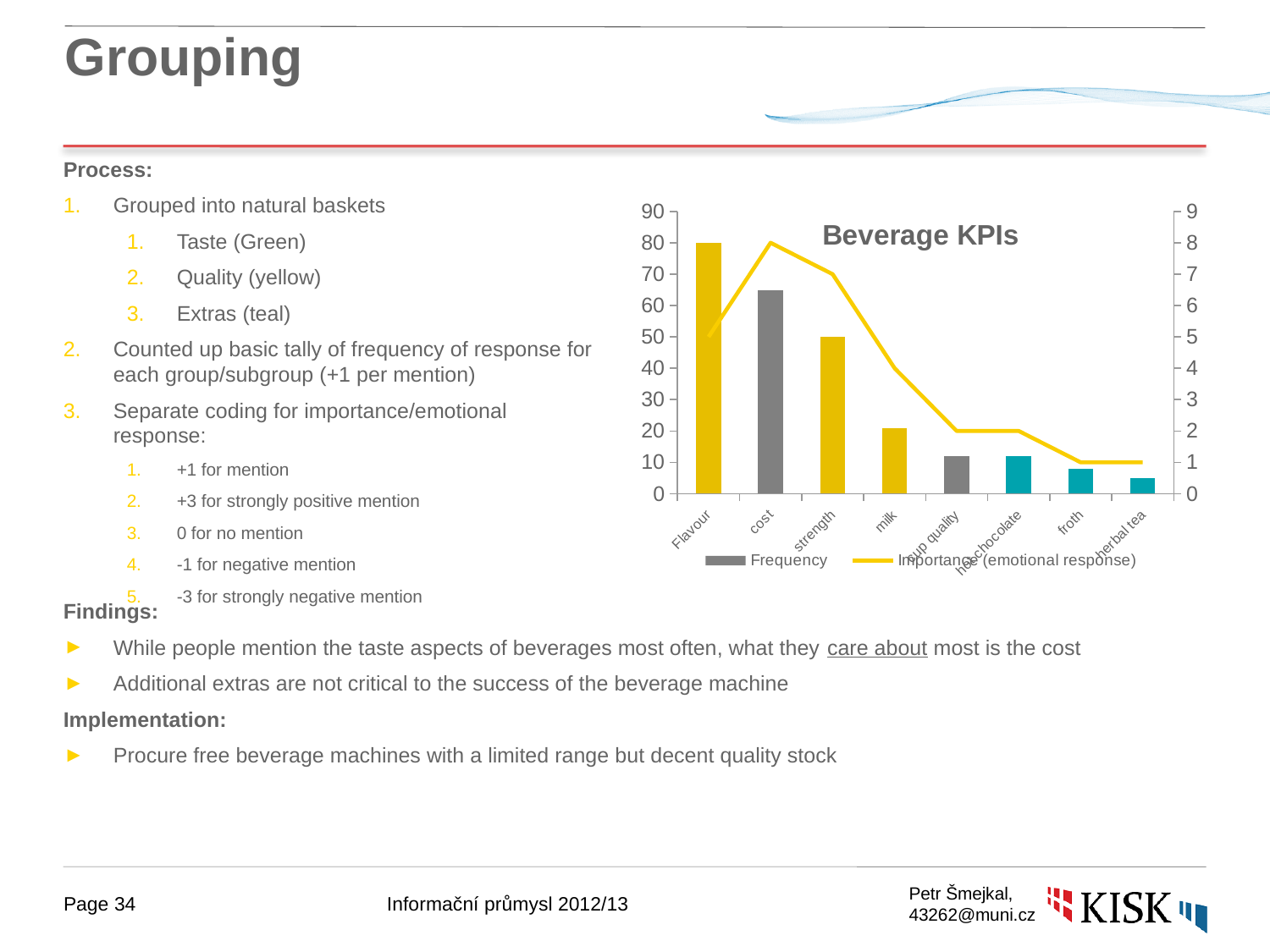
Which category has the lowest Frequency bar in the Beverage KPIs chart? herbal tea What is the title of the chart on the slide? Beverage KPIs How many categories are shown on the x axis of the Beverage KPIs chart? 8 Does the Importance (emotional response) line rise or fall from strength to herbal tea? fall Is the Frequency value for froth greater or less than 10? less Is the Frequency value for cost greater or less than 60? greater Which has the larger Frequency value, Flavour or cost? Flavour Which category has the highest Frequency bar in the Beverage KPIs chart? Flavour Which category has the highest Importance (emotional response) value in the Beverage KPIs chart? cost What kind of chart is the Beverage KPIs chart? A combination bar and line chart How many series does the legend of the Beverage KPIs chart list? 2 Is the Frequency value for milk greater or less than 30? less